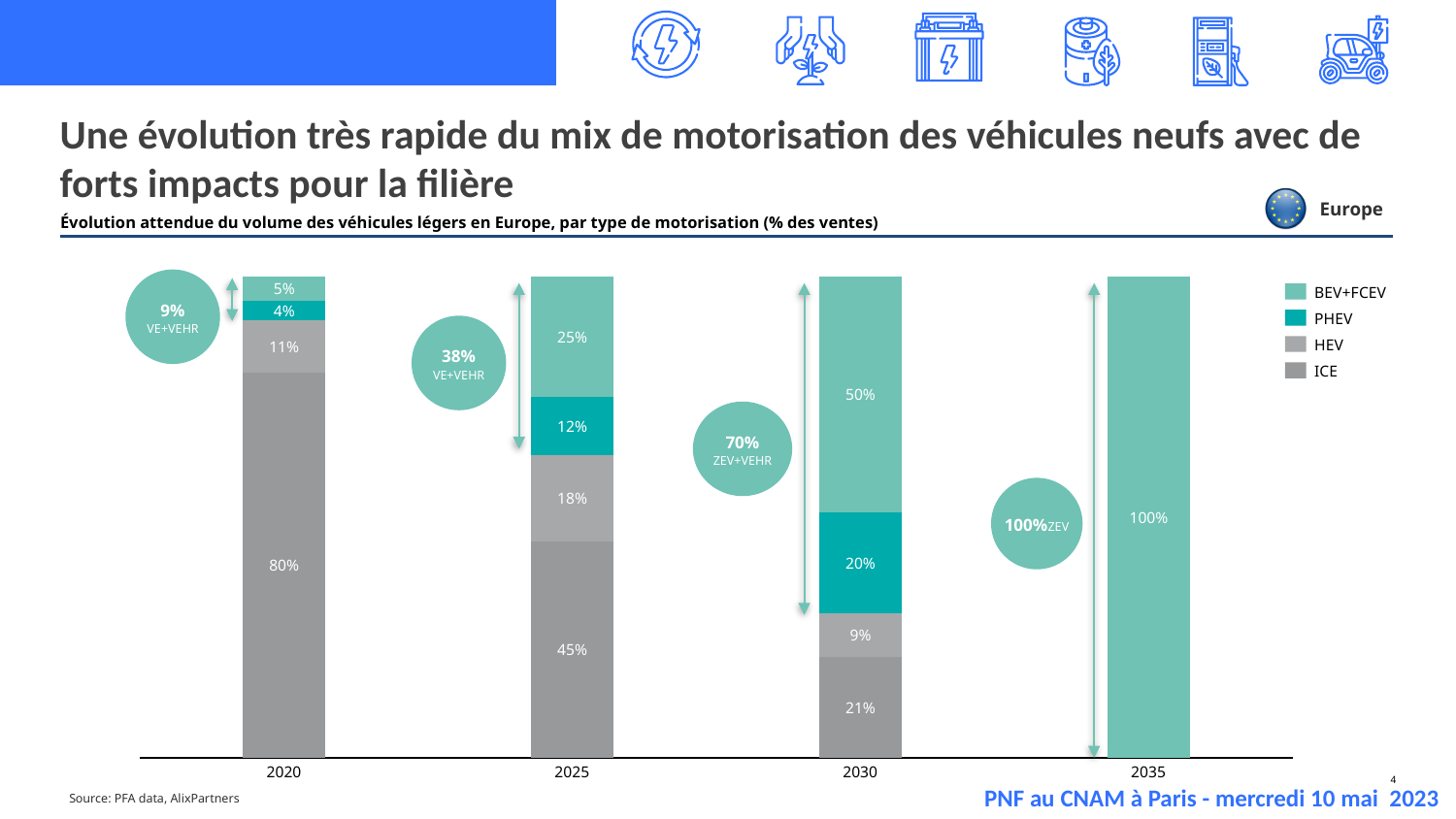
In which year is the ICE share the highest? 2020 How many series does the legend list? 4 Does the BEV+FCEV share rise or fall from 2020 to 2035? Rise How many years are shown on the x axis? 4 What is the ICE share of sales in 2020? 80% What is the BEV+FCEV share of sales in 2030? 50% What is the HEV share of sales in 2030? 9% What is the PHEV share of sales in 2025? 12% What kind of chart is shown on the slide? Stacked bar chart Which is larger in 2030: the PHEV share or the ICE share? ICE In which year is the BEV+FCEV share the lowest? 2020 What is the difference between the ICE share in 2020 and in 2025? 35%